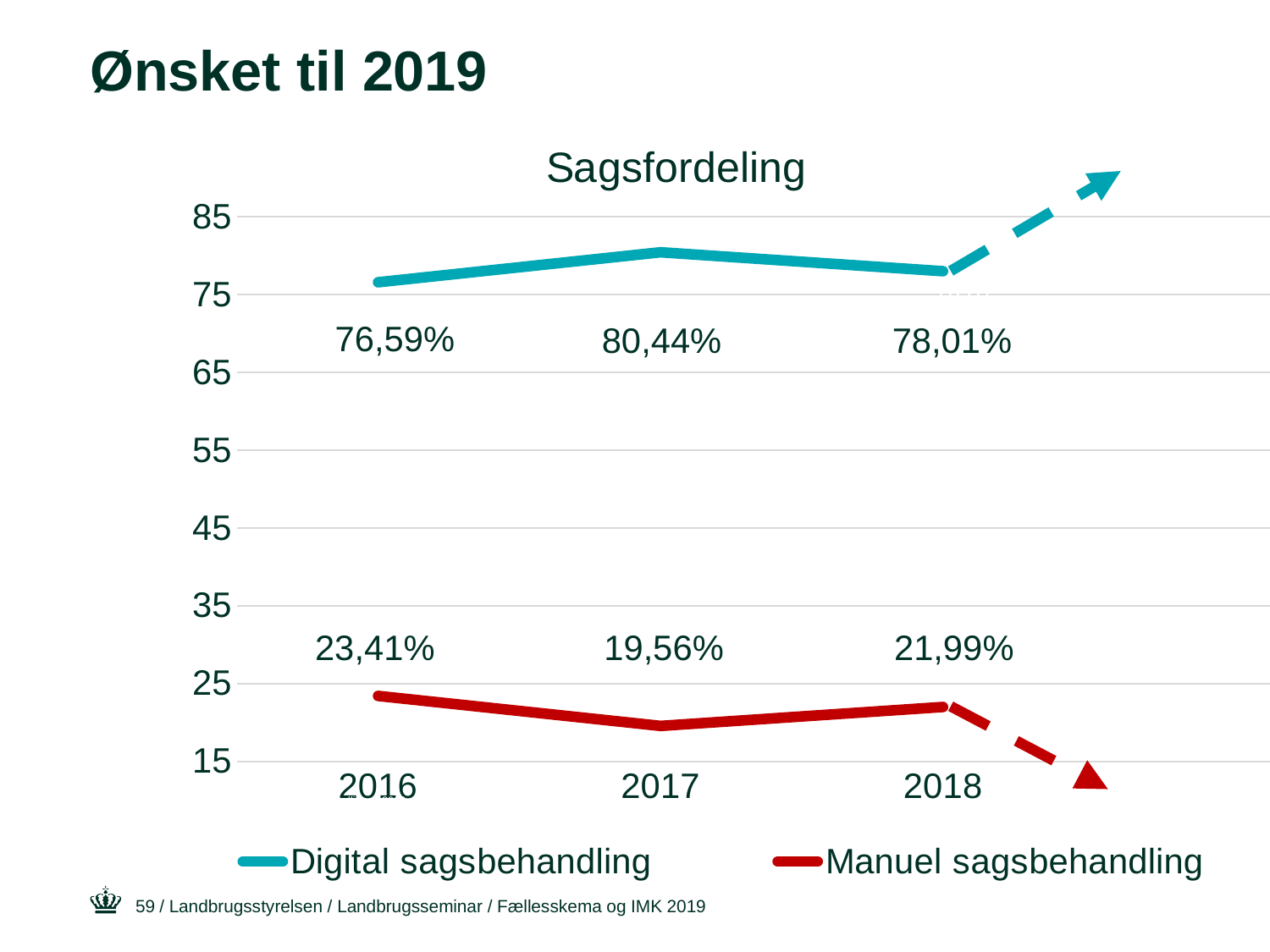
Which is larger in 2018: Digital sagsbehandling or Manuel sagsbehandling? Digital sagsbehandling What type of chart is shown on the slide? Line chart What is the value for Digital sagsbehandling in 2017? 80,44% What is the value for Digital sagsbehandling in 2016? 76,59% What is the difference between Digital sagsbehandling in 2017 and 2016? 3,85% Does Manuel sagsbehandling rise or fall from 2016 to 2017? Fall How many series does the legend list? 2 What is the title of the chart? Sagsfordeling What is the value for Manuel sagsbehandling in 2018? 21,99% How many years are plotted on the x axis? 3 In which year is Digital sagsbehandling highest? 2017 In which year is Manuel sagsbehandling lowest? 2017